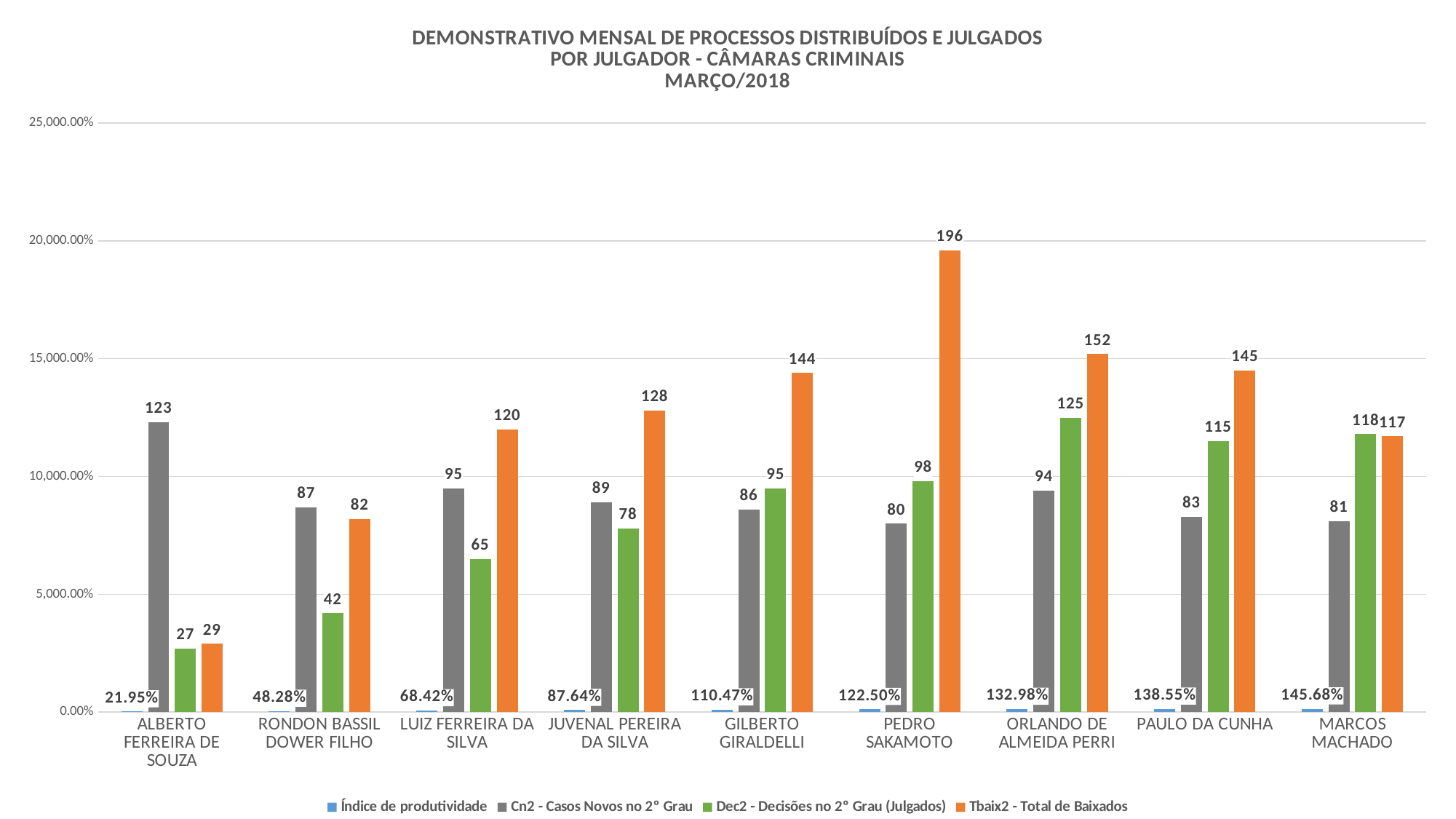
What is the difference between the Tbaix2 - Total de Baixados values for PEDRO SAKAMOTO and ORLANDO DE ALMEIDA PERRI? 44 What is the Tbaix2 - Total de Baixados value for PEDRO SAKAMOTO? 196 How many judges are shown on the x axis? 9 Which judge has the highest Tbaix2 - Total de Baixados value? PEDRO SAKAMOTO What is the Dec2 - Decisões no 2° Grau (Julgados) value for PAULO DA CUNHA? 115 What kind of chart is shown on the slide? Bar chart How many series does the legend list? 4 Does the Índice de produtividade rise or fall from left to right along the x axis? Rise What is the Índice de produtividade for ORLANDO DE ALMEIDA PERRI? 132.98% Which is larger for MARCOS MACHADO: the Dec2 - Decisões no 2° Grau (Julgados) value or the Tbaix2 - Total de Baixados value? Dec2 - Decisões no 2° Grau (Julgados) Which judge has the lowest Dec2 - Decisões no 2° Grau (Julgados) value? ALBERTO FERREIRA DE SOUZA What is the Cn2 - Casos Novos no 2° Grau value for ALBERTO FERREIRA DE SOUZA? 123